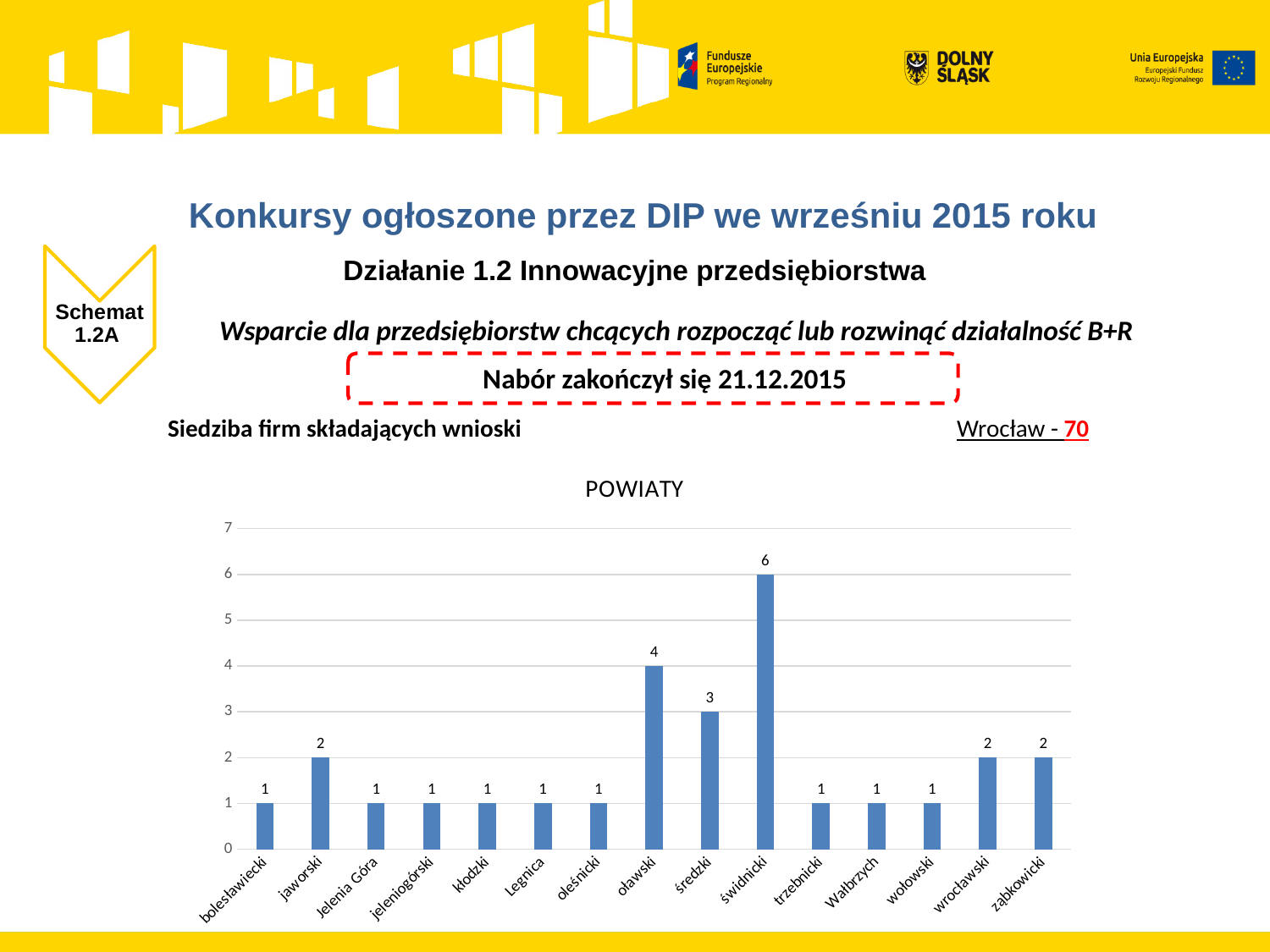
Is the value for świdnicki in the POWIATY chart greater or less than 5? greater What is the difference between the values for świdnicki and oławski in the POWIATY chart? 2 Which is larger in the POWIATY chart, the value for oławski or the value for ząbkowicki? oławski What is the title of the chart on the slide? POWIATY What is the value for oławski in the POWIATY chart? 4 What is the value for świdnicki in the POWIATY chart? 6 What is the value for jaworski in the POWIATY chart? 2 What is the difference between the values for średzki and wrocławski in the POWIATY chart? 1 Which category has the highest value in the POWIATY chart? świdnicki What kind of chart is the POWIATY chart? bar chart What is the value for średzki in the POWIATY chart? 3 How many categories are shown on the x axis of the POWIATY chart? 15